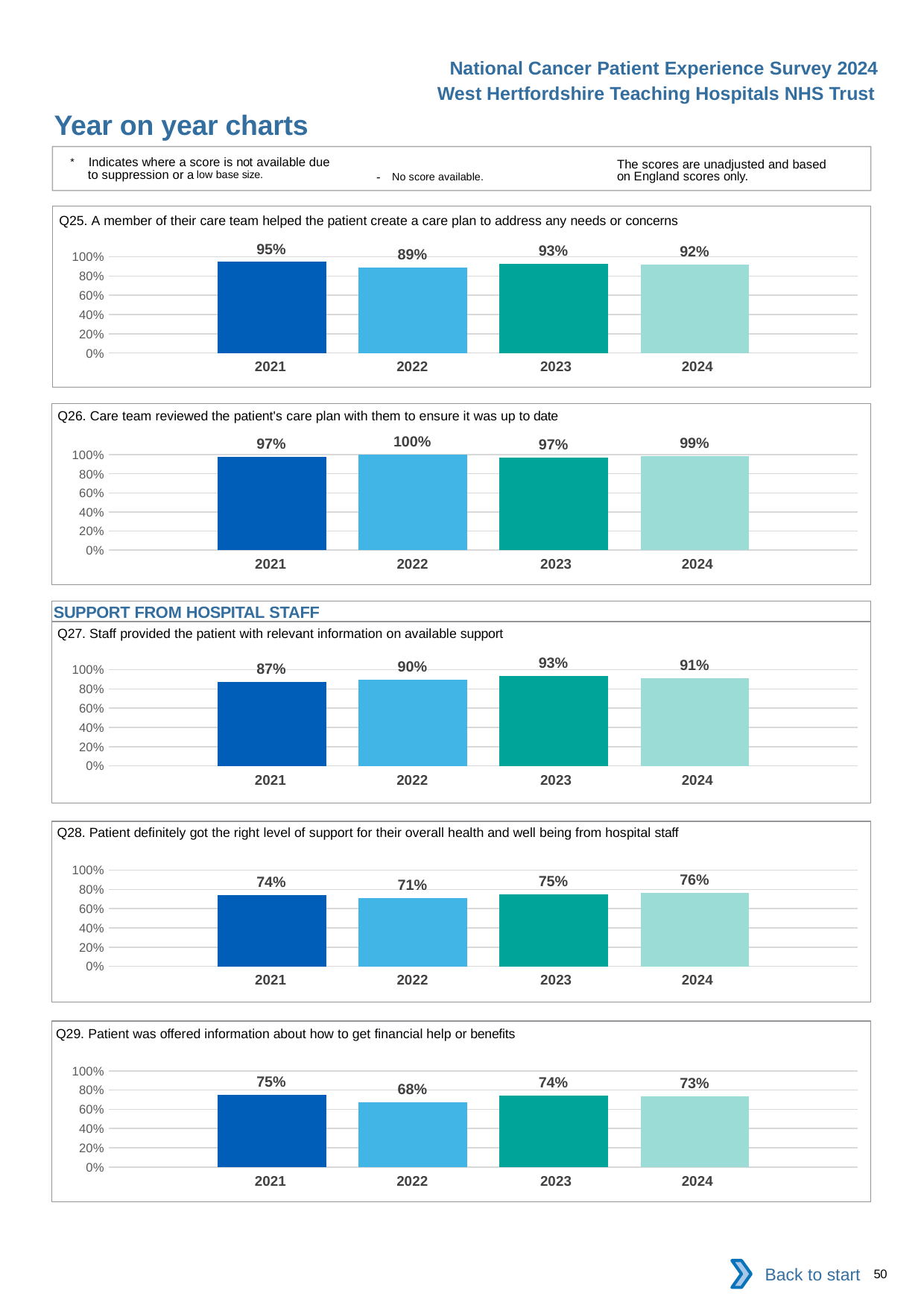
In the Q27 chart, what is the difference between the 2023 value and the 2021 value? 6% In the Q25 chart, what is the value for 2021? 95% In the Q28 chart, which is larger, the value for 2021 or the value for 2022? 2021 In the Q28 chart, what is the value for 2024? 76% In the Q25 chart, which year has the lowest value? 2022 In the Q27 chart, which year has the highest value? 2023 In the Q29 chart, is the value for 2021 greater or less than 60%? greater What kind of chart is the Q28 chart? Bar chart How many years are shown in the Q29 chart? 4 In the Q26 chart, what is the difference between the 2024 value and the 2023 value? 2% In the Q26 chart, what is the value for 2022? 100% In the Q29 chart, what is the value for 2022? 68%